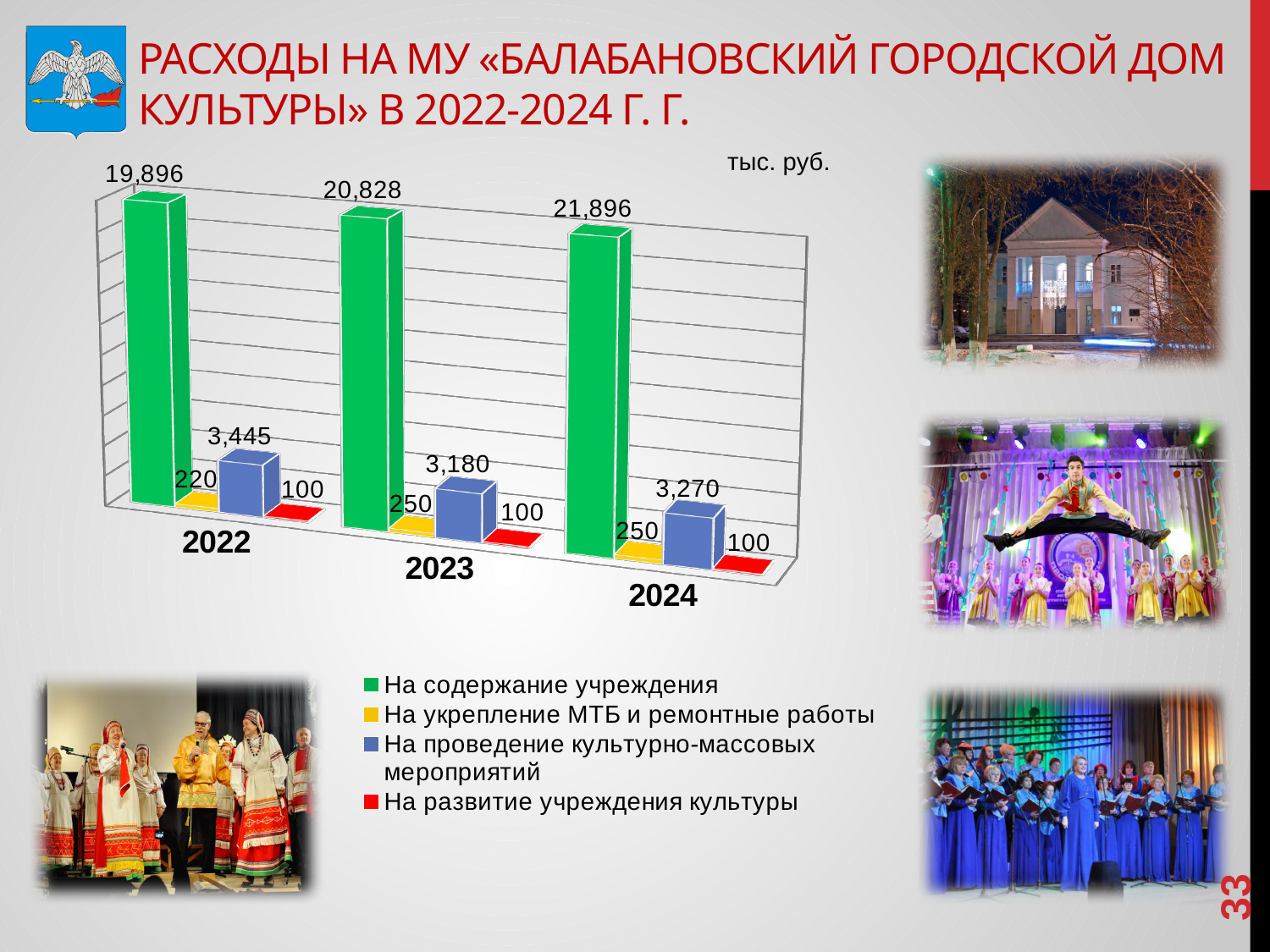
What kind of chart is shown on the slide? Bar chart What is the difference between the «На содержание учреждения» values for 2024 and 2022? 2,000 What is the value for «На укрепление МТБ и ремонтные работы» in 2023? 250 In which year is the value for «На содержание учреждения» the highest? 2024 What is the value for «На содержание учреждения» in 2024? 21,896 What is the value for «На проведение культурно-массовых мероприятий» in 2022? 3,445 What is the value for «На развитие учреждения культуры» in 2024? 100 In which year is the value for «На проведение культурно-массовых мероприятий» the lowest? 2023 Which is larger: «На проведение культурно-массовых мероприятий» in 2022 or in 2024? 2022 How many years (categories) are shown on the x axis of the chart? 3 Does the value for «На содержание учреждения» rise or fall from 2022 to 2024? Rise How many series does the chart legend list? 4